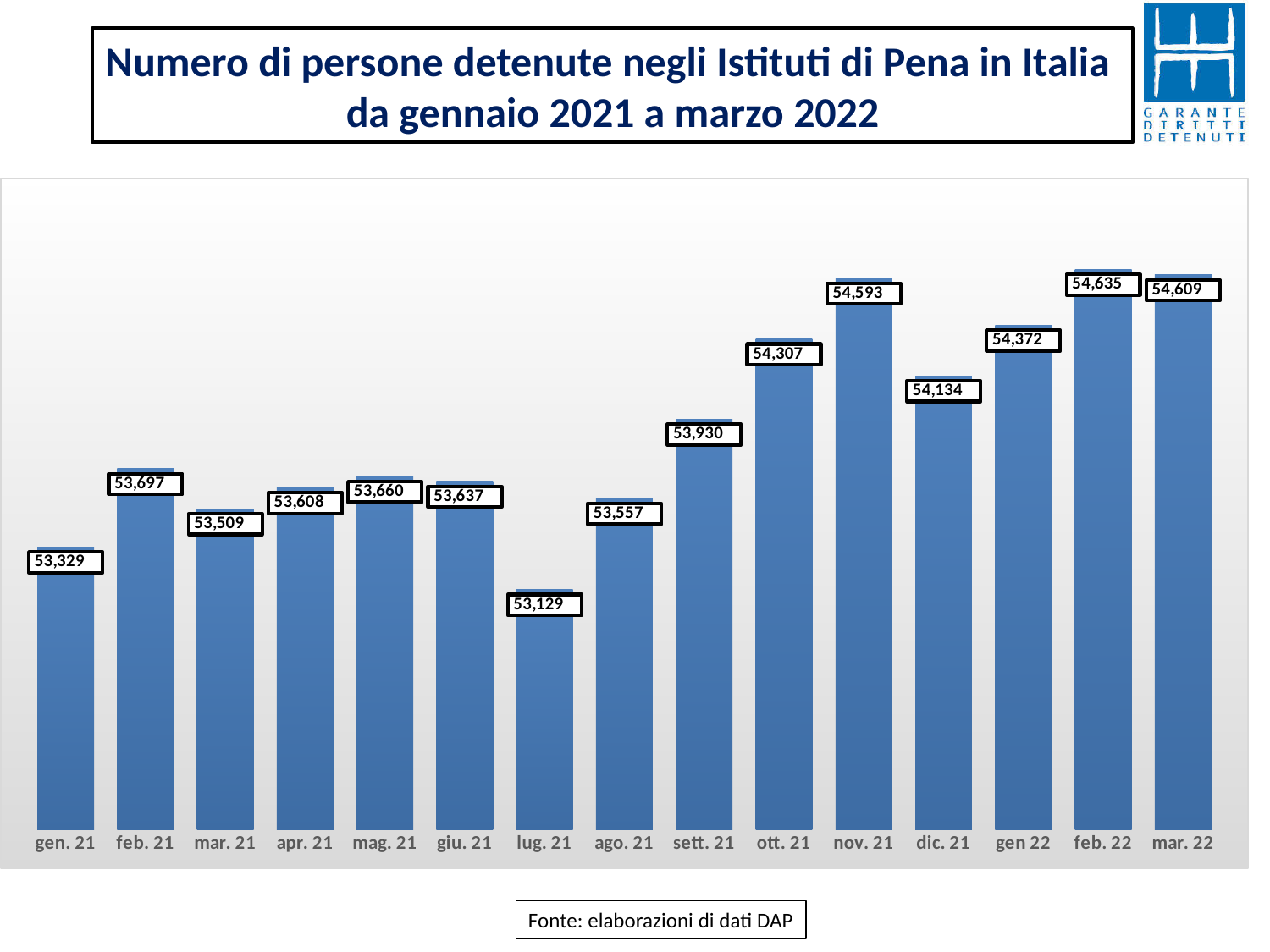
What is the number of detained persons shown for gen. 21? 53,329 What is the difference between the values for feb. 22 and gen. 21? 1,306 What value is shown for mar. 22? 54,609 What kind of chart is shown on the slide? bar chart What is the source cited below the chart? Fonte: elaborazioni di dati DAP Which month has the lowest value in the chart? lug. 21 What is the difference between the values for nov. 21 and dic. 21? 459 What value is shown for lug. 21? 53,129 Which month has the highest value in the chart? feb. 22 Which is larger, the value for ott. 21 or the value for gen 22? gen 22 What value is shown for nov. 21? 54,593 How many months are shown on the x axis of the chart? 15